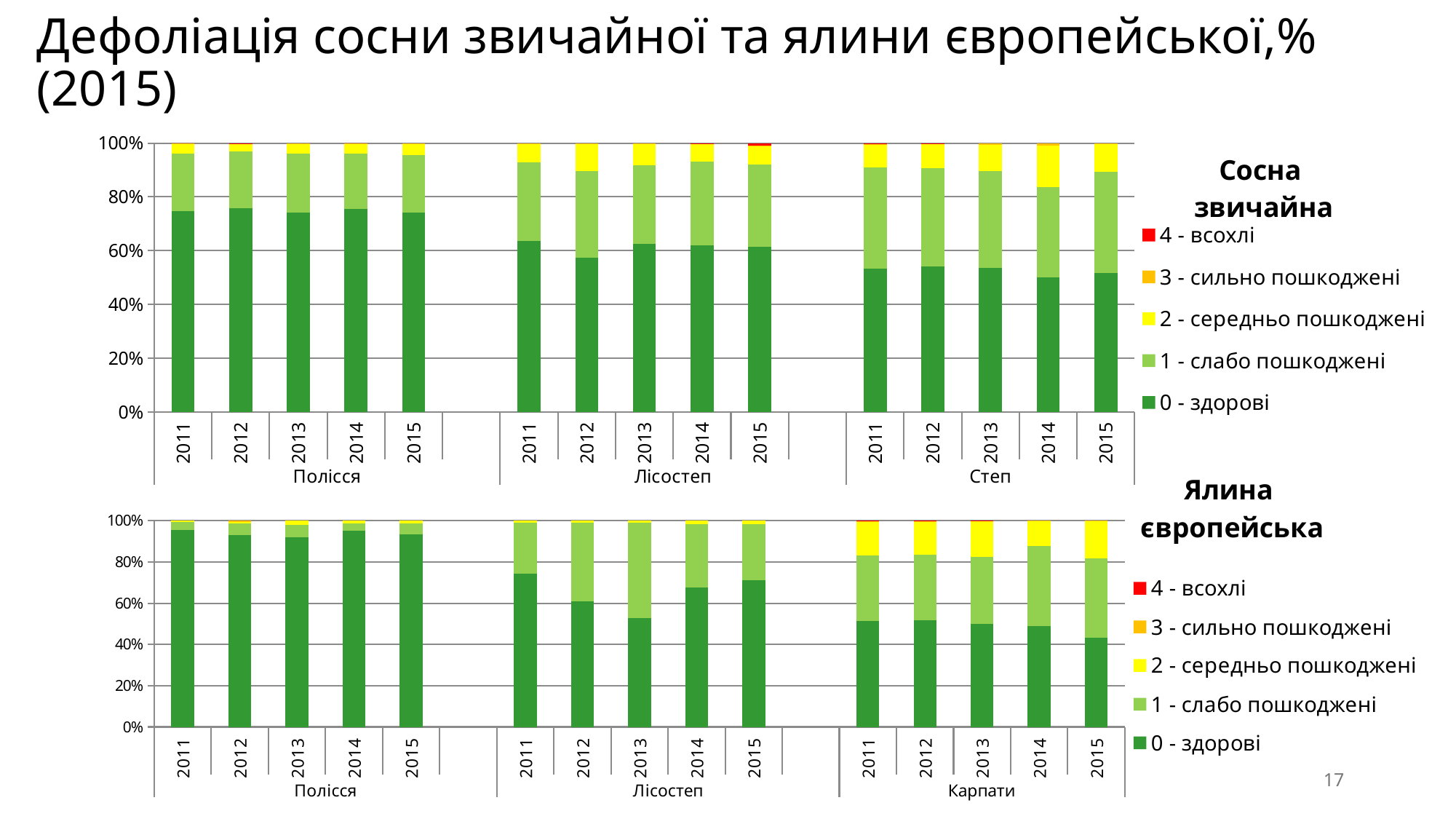
What kind of chart is the top chart (Сосна звичайна)? stacked bar chart In the top chart (Сосна звичайна), which has the larger share of '0 - здорові' in 2011: Полісся or Степ? Полісся How many regions are shown along the x axis of the bottom chart (Ялина європейська)? 3 How many series does the legend of the top chart (Сосна звичайна) list? 5 Which region appears in the bottom chart (Ялина європейська) but not in the top chart (Сосна звичайна)? Карпати How many bars are plotted in the top chart (Сосна звичайна)? 15 In the top chart (Сосна звичайна), is the share of '0 - здорові' for Полісся in 2011 greater or less than 60%? greater In the bottom chart (Ялина європейська), is the share of '0 - здорові' for Полісся in 2011 greater or less than 80%? greater In the bottom chart (Ялина європейська), which region has the lowest share of '0 - здорові' in 2015? Карпати In the top chart (Сосна звичайна), is the share of '0 - здорові' for Степ in 2014 greater or less than 60%? less In the bottom chart (Ялина європейська), which region has the highest share of '0 - здорові' in 2013? Полісся